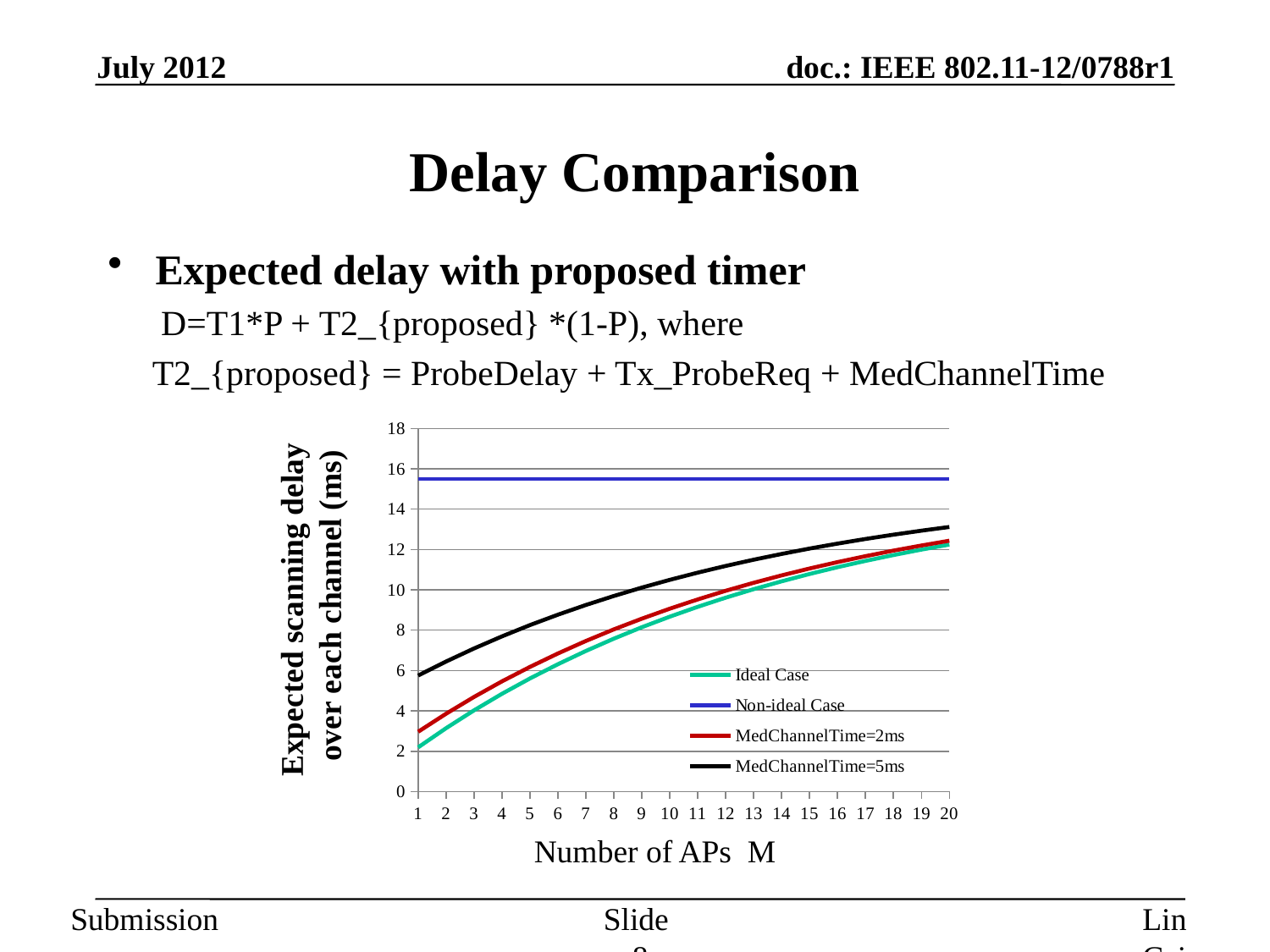
At M=1, which is larger: the Ideal Case value or the MedChannelTime=5ms value? MedChannelTime=5ms What kind of chart is shown on the slide? line chart Does the Ideal Case delay rise or fall as the number of APs M increases? rise Is the value for Non-ideal Case at M=10 greater or less than 14? greater Is the value for MedChannelTime=5ms at M=20 greater or less than 12? greater Which series has the highest expected scanning delay across the whole range of M? Non-ideal Case How many series does the chart legend list? 4 What is the title of the x axis? Number of APs M Which series has the lowest expected scanning delay at M=1? Ideal Case Is the value for Ideal Case at M=1 greater or less than 4? less How many values of M (Number of APs) are shown along the x axis? 20 Does the Non-ideal Case delay change as M increases, or stay flat? stay flat